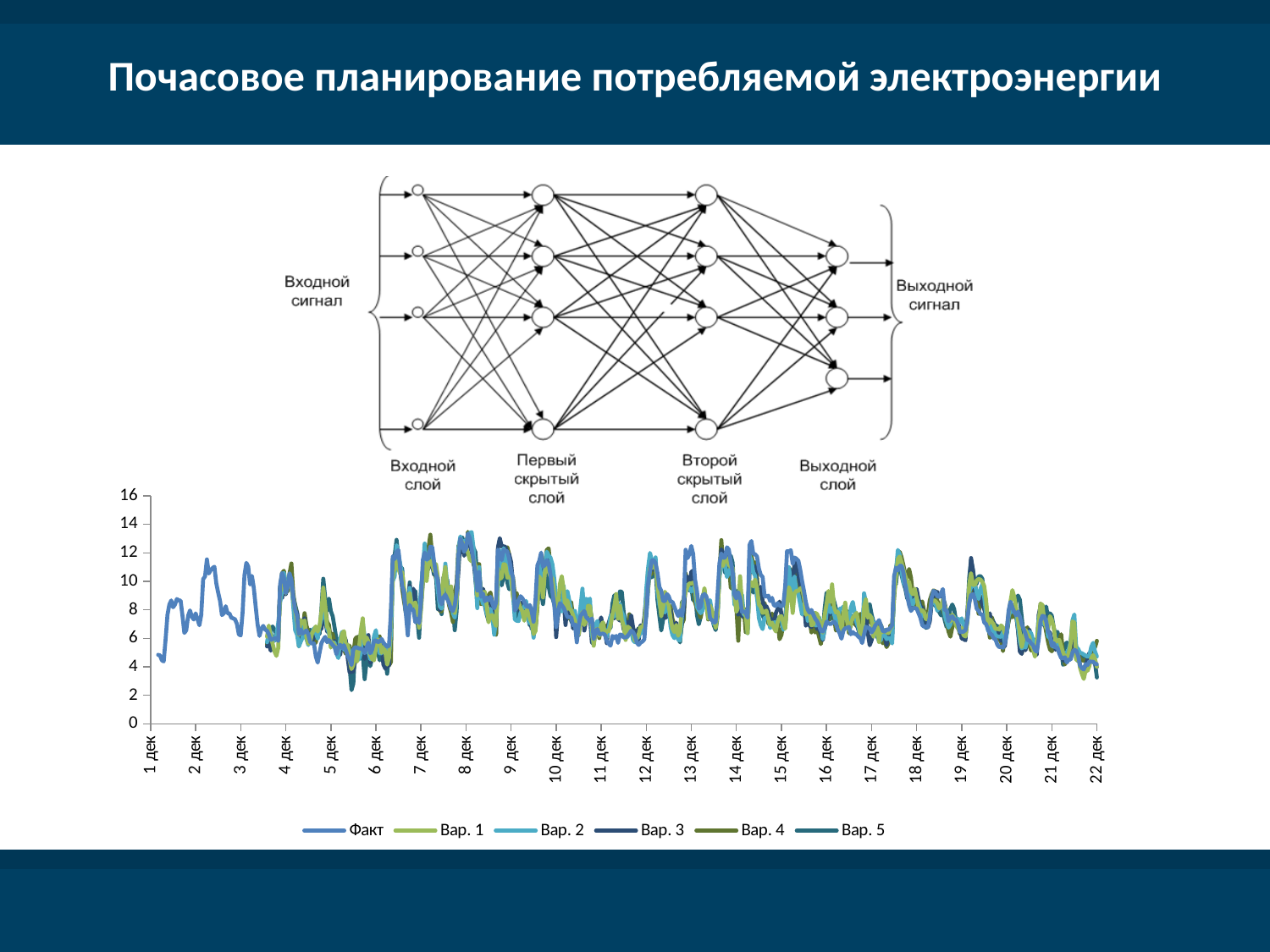
What is the name of the first series in the legend of the line chart? Факт How many date labels are shown on the horizontal axis of the line chart? 22 What is the last date label on the horizontal axis of the line chart? 22 дек Is the lowest value reached by any line in the chart (near 6 дек) greater or less than 4? less What is the highest value shown on the vertical axis of the line chart? 16 Is the peak value of the lines around 8 дек greater or less than 10? greater What is the first date label on the horizontal axis of the line chart? 1 дек What is the name of the last series in the legend of the line chart? Вар. 5 What kind of chart is shown at the bottom of the slide? line chart Do the values in the line chart generally rise or fall between 18 дек and 22 дек? fall How many series does the legend of the line chart list? 6 Is the highest value reached by any line in the chart greater or less than 14? less